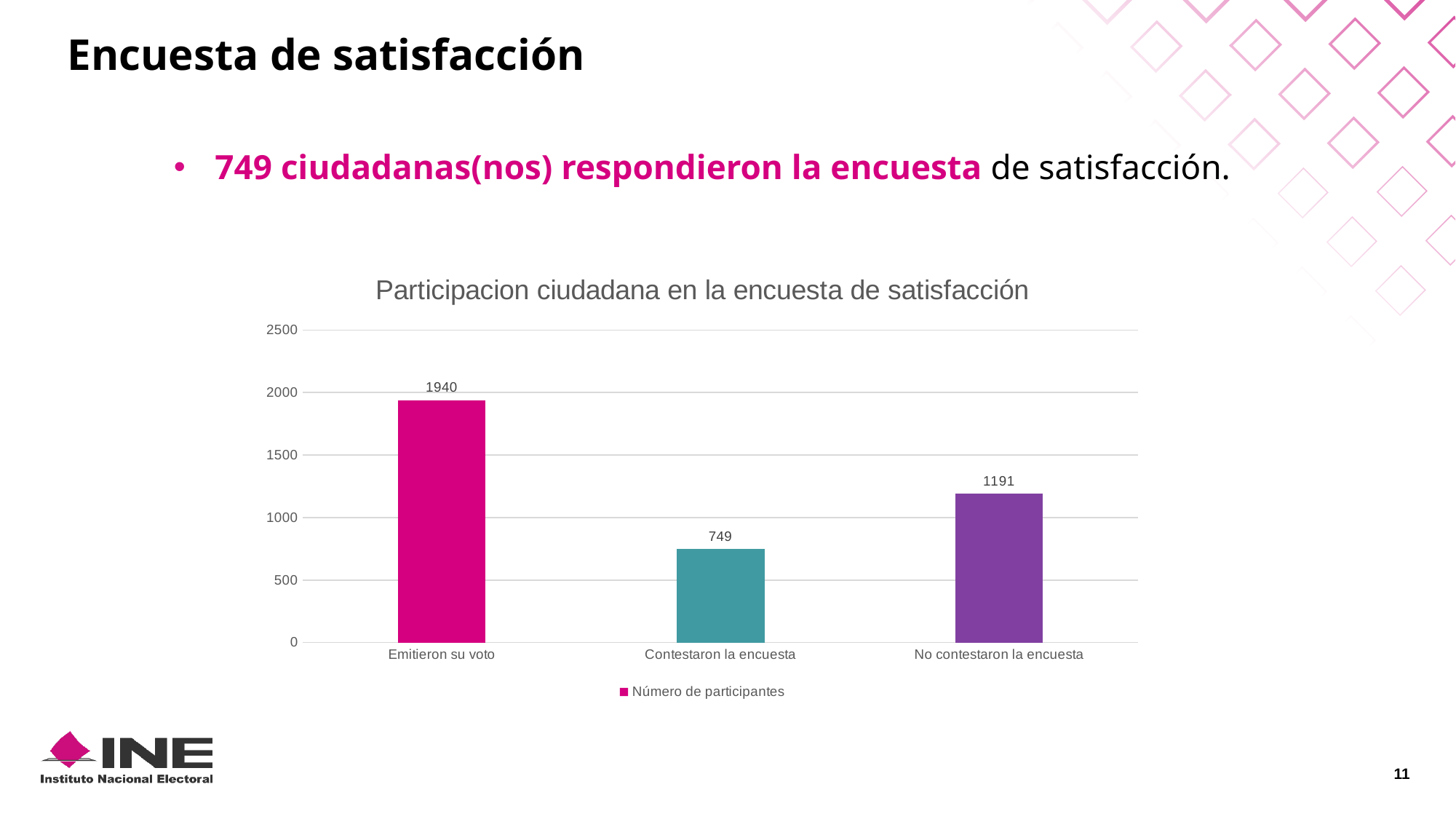
Which is larger, "No contestaron la encuesta" or "Contestaron la encuesta"? No contestaron la encuesta What is the value for "Emitieron su voto"? 1940 What is the difference between "No contestaron la encuesta" and "Contestaron la encuesta"? 442 Is the value for "Emitieron su voto" greater or less than 1500? greater What is the value for "No contestaron la encuesta"? 1191 What is the value for "Contestaron la encuesta"? 749 What is the difference between "Emitieron su voto" and "Contestaron la encuesta"? 1191 Which category has the highest value? Emitieron su voto What kind of chart is shown on the slide? Bar chart Which category has the lowest value? Contestaron la encuesta What is the title of the chart? Participacion ciudadana en la encuesta de satisfacción How many categories are shown on the x axis? 3